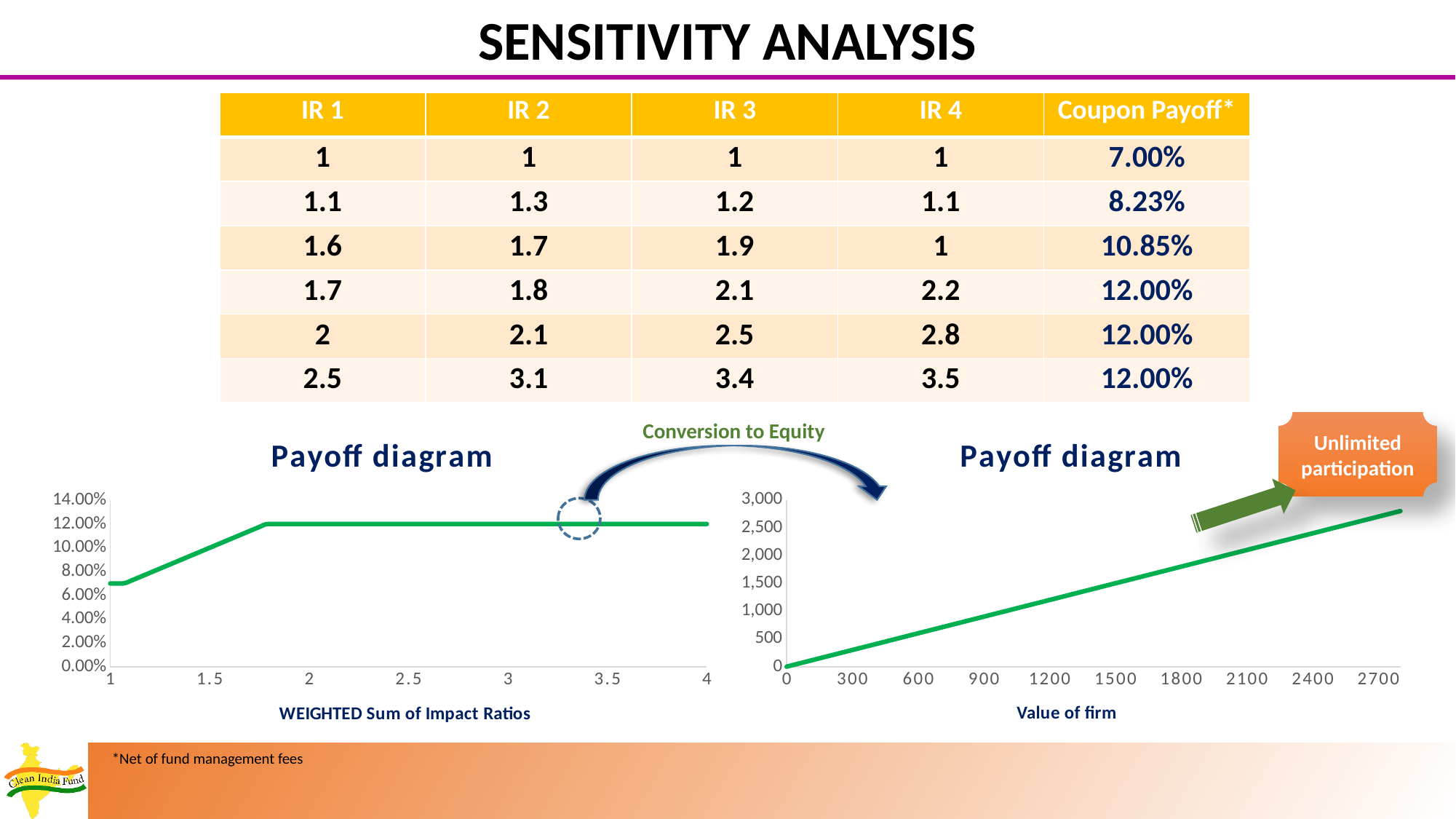
In the right Payoff diagram, does the line rise or fall as the value of firm increases? rise In the left Payoff diagram, does the line rise or fall between a weighted sum of impact ratios of 1 and 1.5? rise In the right Payoff diagram, is the value at a value of firm of 300 greater or less than 500? less What kind of chart is the right Payoff diagram? line chart What kind of chart is the left Payoff diagram? line chart In the right Payoff diagram, is the value at a value of firm of 2700 greater or less than 2,000? greater In the right Payoff diagram, is the value at a value of firm of 1500 greater or less than 1,000? greater What is the x-axis title of the left Payoff diagram? WEIGHTED Sum of Impact Ratios What is the x-axis title of the right Payoff diagram? Value of firm